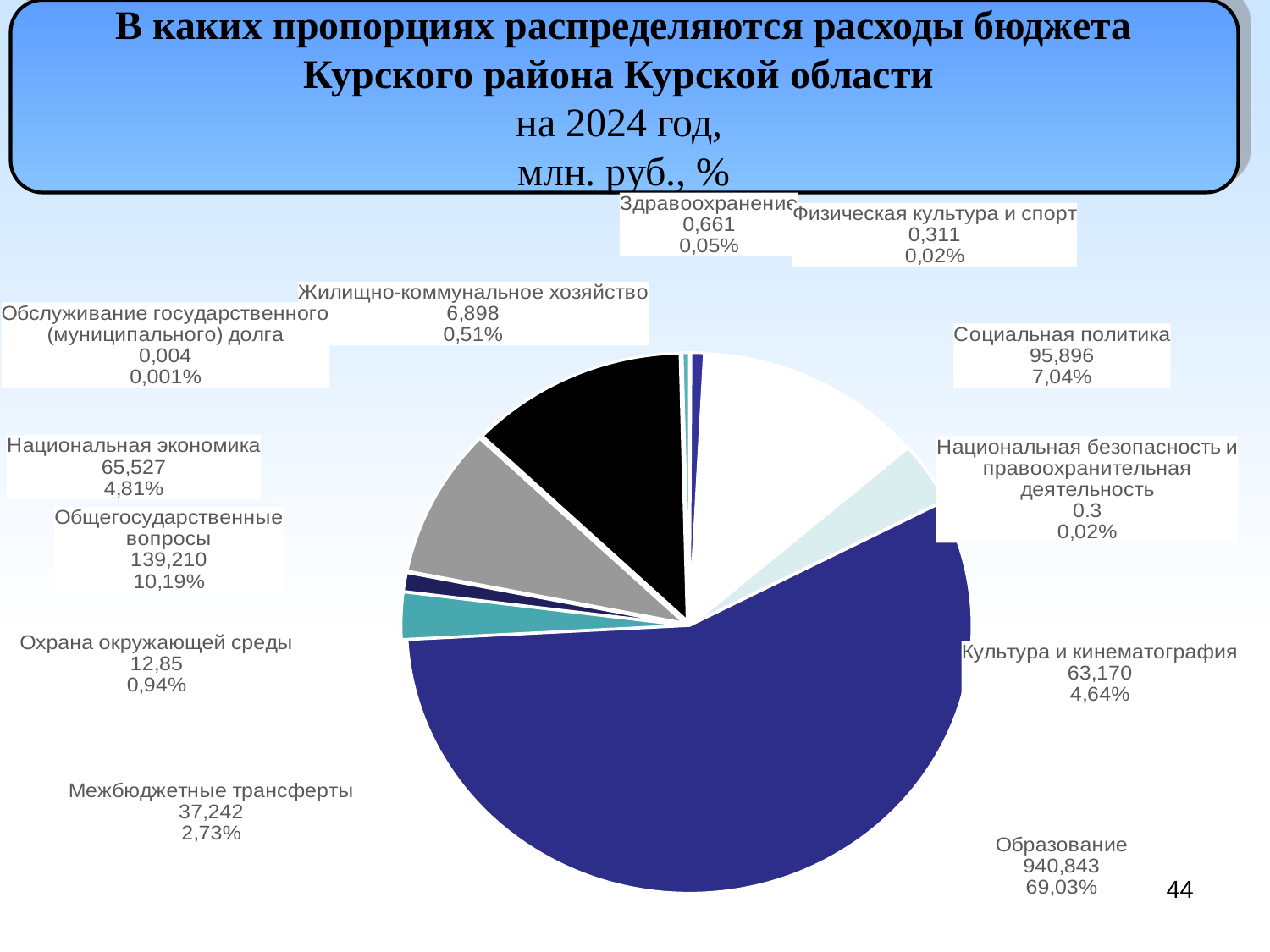
What is the value shown for Межбюджетные трансферты? 37,242 Which category has the largest slice of the pie? Образование What percentage is shown for Социальная политика? 7,04% What year does the chart title say the budget expenditures are for? 2024 What is the difference between the values for Общегосударственные вопросы and Национальная экономика? 73,683 What is the value for Общегосударственные вопросы? 139,210 Which is larger: the value for Национальная экономика or for Культура и кинематография? Национальная экономика What share of the pie does Образование account for? 69,03% How many categories (slices) does the pie chart show? 12 What kind of chart is shown on the slide? pie chart What is the value for Образование in the pie chart? 940,843 Which category has the smallest value in the pie chart? Обслуживание государственного (муниципального) долга